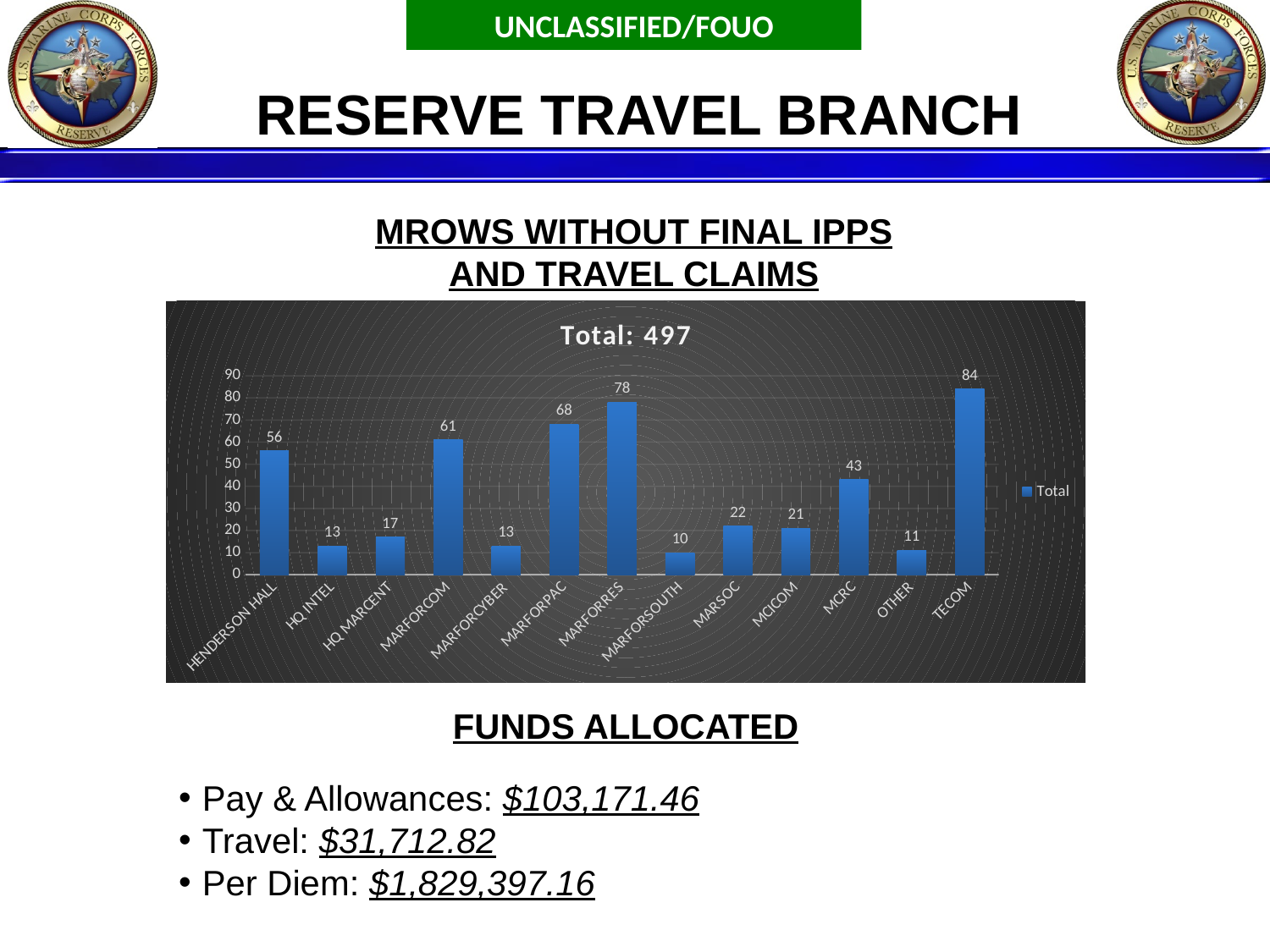
Is the value for MARSOC greater or less than 30? less What is the value for MCRC? 43 What is the value for TECOM? 84 What kind of chart is shown? bar chart What is the title of the chart? Total: 497 Which category has the highest value? TECOM What is the value for MARFORCOM? 61 Which category has the lowest value? MARFORSOUTH How many categories are shown on the x axis? 13 Which is larger, the value for HENDERSON HALL or the value for MARFORCOM? MARFORCOM How many series does the legend list? 1 What is the difference between the values for MARFORRES and MARFORPAC? 10